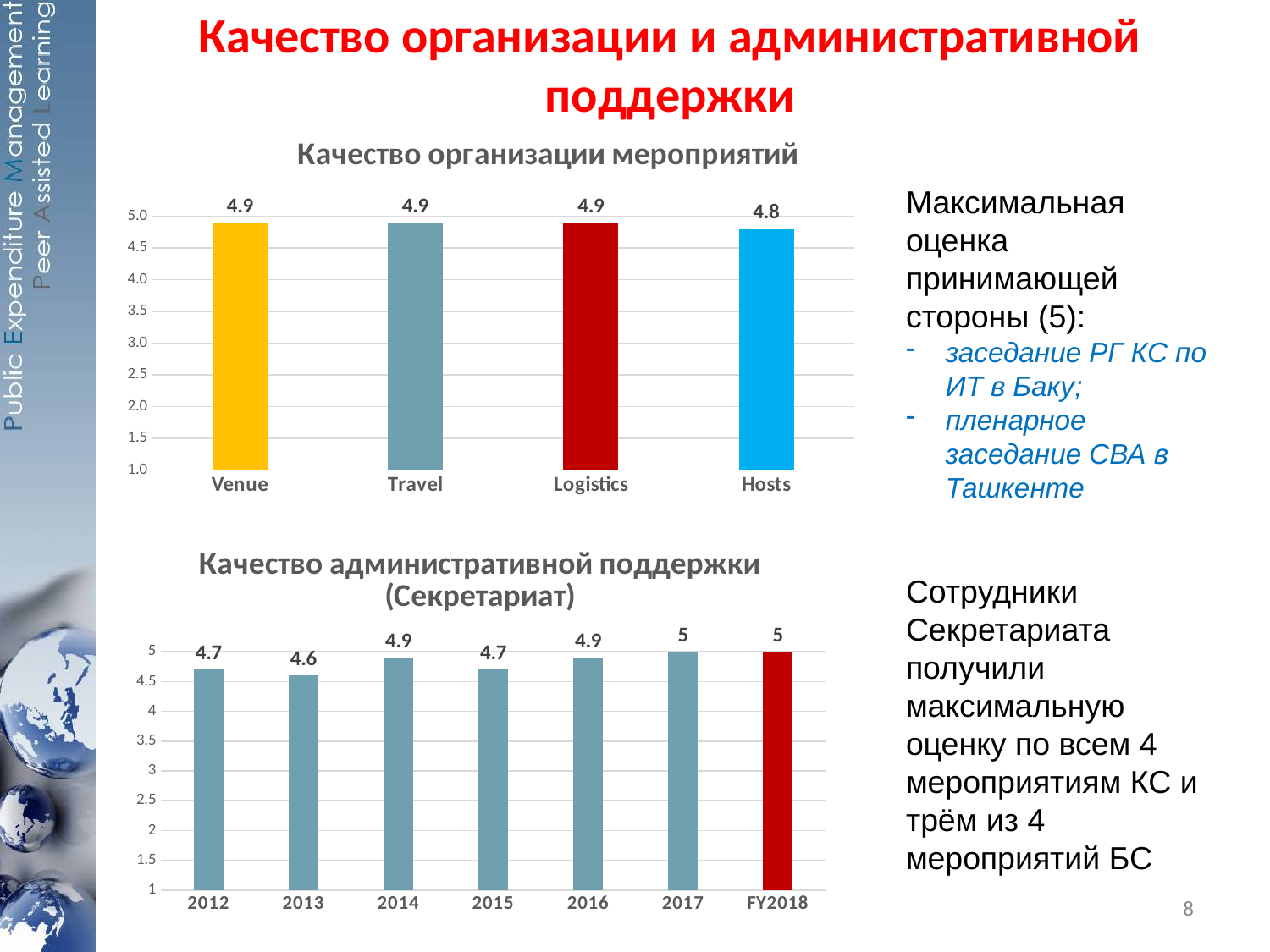
What type of chart is the bottom chart on the slide? bar chart In the chart 'Качество организации мероприятий', which category has the lowest value? Hosts In the chart 'Качество административной поддержки (Секретариат)', which year has the lowest value? 2013 In the chart 'Качество организации мероприятий', what is the difference between the values for Travel and Hosts? 0.1 In the chart 'Качество организации мероприятий', how many categories are shown? 4 In the chart 'Качество административной поддержки (Секретариат)', what is the difference between the values for 2017 and 2013? 0.4 In the chart 'Качество административной поддержки (Секретариат)', what is the value for FY2018? 5 In the chart 'Качество организации мероприятий', what is the value for Venue? 4.9 In the chart 'Качество административной поддержки (Секретариат)', how many bars are shown? 7 In the chart 'Качество административной поддержки (Секретариат)', is the value for 2014 larger or smaller than the value for 2015? larger In the chart 'Качество административной поддержки (Секретариат)', what is the value for 2013? 4.6 In the chart 'Качество организации мероприятий', what is the value for Hosts? 4.8